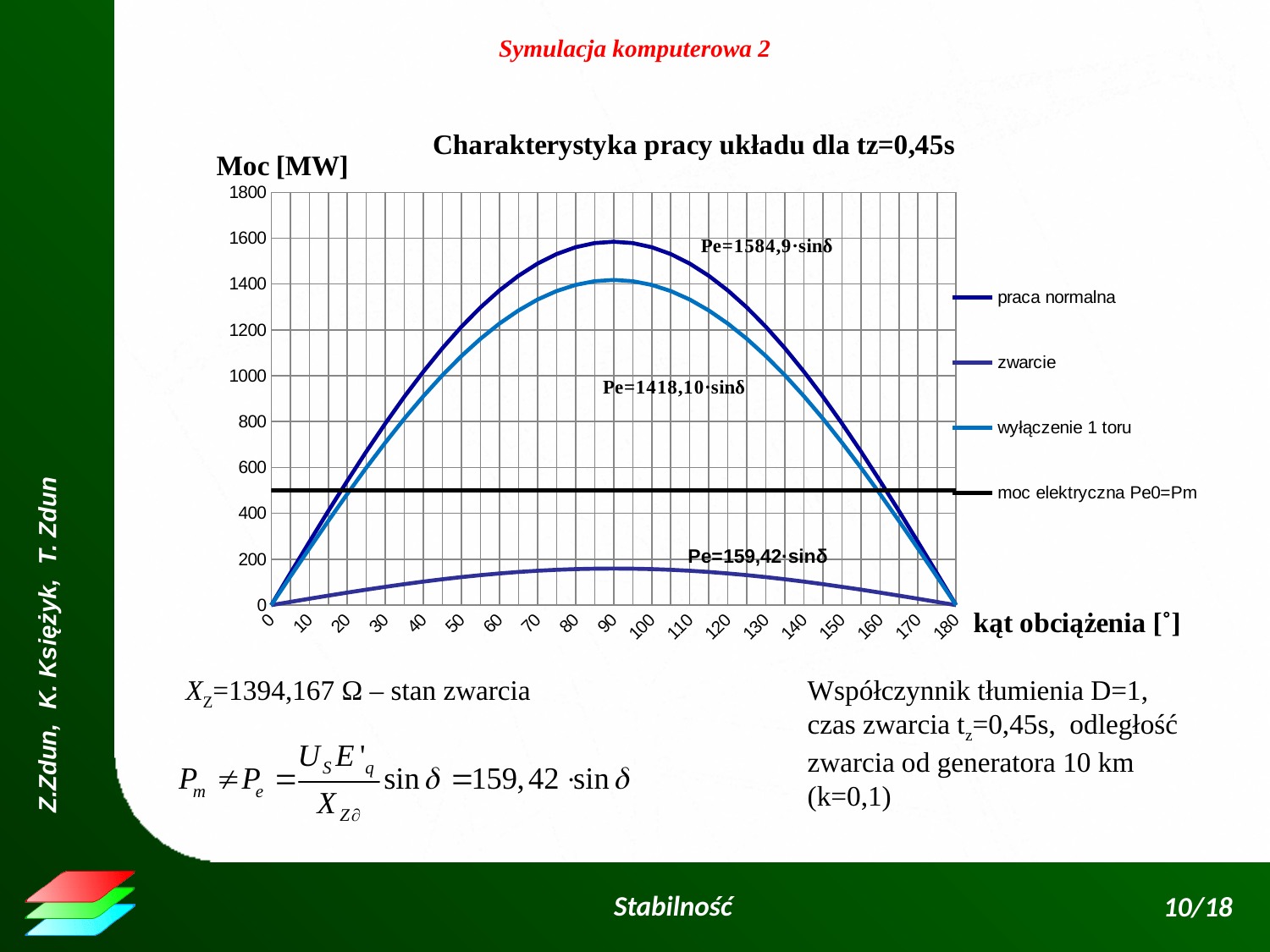
What is the difference between the amplitudes of the 'praca normalna' and 'wyłączenie 1 toru' curves, based on the printed labels? 166,8 Is the peak value of the 'zwarcie' curve greater or less than 200 MW? less How many series does the chart legend list? 4 What is the title of the chart? Charakterystyka pracy układu dla tz=0,45s Is the horizontal line 'moc elektryczna Pe0=Pm' greater or less than 400 MW? greater Which series reaches the highest peak value on the chart? praca normalna What kind of chart is shown on the slide? line chart According to the label on the chart, what is the amplitude of the 'zwarcie' curve (Pe = ? · sinδ)? 159,42 According to the label on the chart, what is the amplitude of the 'praca normalna' curve (Pe = ? · sinδ)? 1584,9 Which sinusoidal series has the lowest peak value on the chart? zwarcie According to the label on the chart, what is the amplitude of the 'wyłączenie 1 toru' curve (Pe = ? · sinδ)? 1418,10 Does the 'praca normalna' curve rise or fall as the load angle increases from 90° to 180°? fall